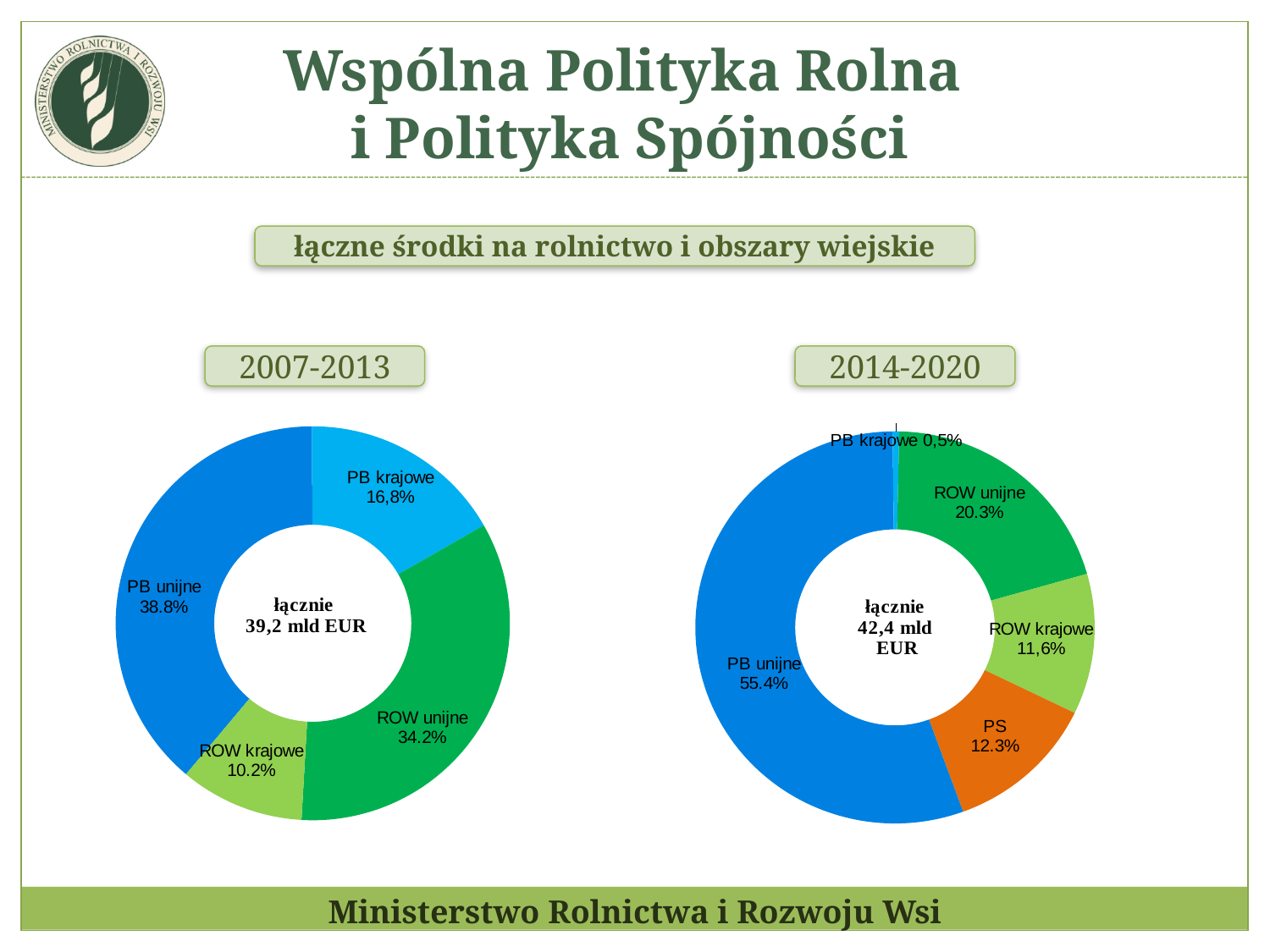
In the 2014-2020 chart, which category has the largest share? PB unijne In the 2007-2013 chart, what is the difference between the shares of PB unijne and ROW unijne? 4.6 percentage points In the 2007-2013 chart, what share does PB krajowe have? 16,8% How many categories are shown in the 2014-2020 chart? 5 In the 2014-2020 chart, what share does PS have? 12.3% What total amount is shown in the centre of the 2014-2020 chart? 42,4 mld EUR In the 2014-2020 chart, which is larger: the share of ROW unijne or the share of PS? ROW unijne In the 2007-2013 chart, what share does PB unijne have? 38.8% In the 2014-2020 chart, which category has the smallest share? PB krajowe In the 2007-2013 chart, which category has the smallest share? ROW krajowe In the 2014-2020 chart, what share does ROW krajowe have? 11,6% What type of chart is used for the 2007-2013 data? Pie (donut) chart